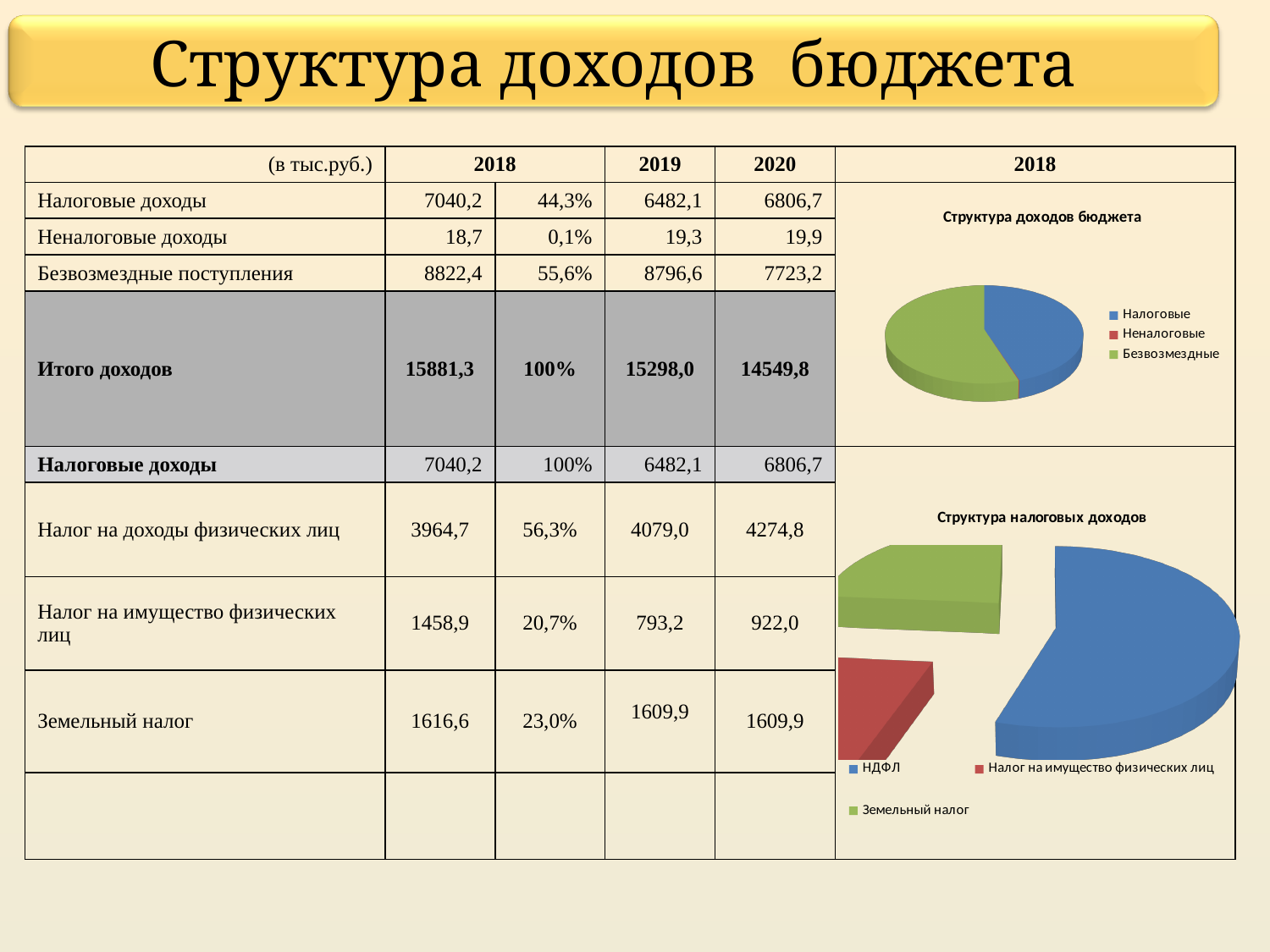
In the chart titled "Структура налоговых доходов", which slice is larger: Земельный налог or Налог на имущество физических лиц? Земельный налог In the chart titled "Структура налоговых доходов", what colour is the НДФЛ slice? blue What kind of chart is the chart titled "Структура доходов бюджета"? pie chart In the chart titled "Структура налоговых доходов", which category has the smallest slice? Налог на имущество физических лиц In the chart titled "Структура налоговых доходов", which category has the largest slice? НДФЛ What kind of chart is the chart titled "Структура налоговых доходов"? pie chart In the chart titled "Структура доходов бюджета", which category has the smallest slice? Неналоговые In the chart titled "Структура налоговых доходов", how many entries does the legend list? 3 In the chart titled "Структура доходов бюджета", how many entries does the legend list? 3 In the chart titled "Структура доходов бюджета", which category has the largest slice? Безвозмездные In the chart titled "Структура доходов бюджета", which slice is larger: Налоговые or Безвозмездные? Безвозмездные In the chart titled "Структура доходов бюджета", what colour is the Безвозмездные slice? green